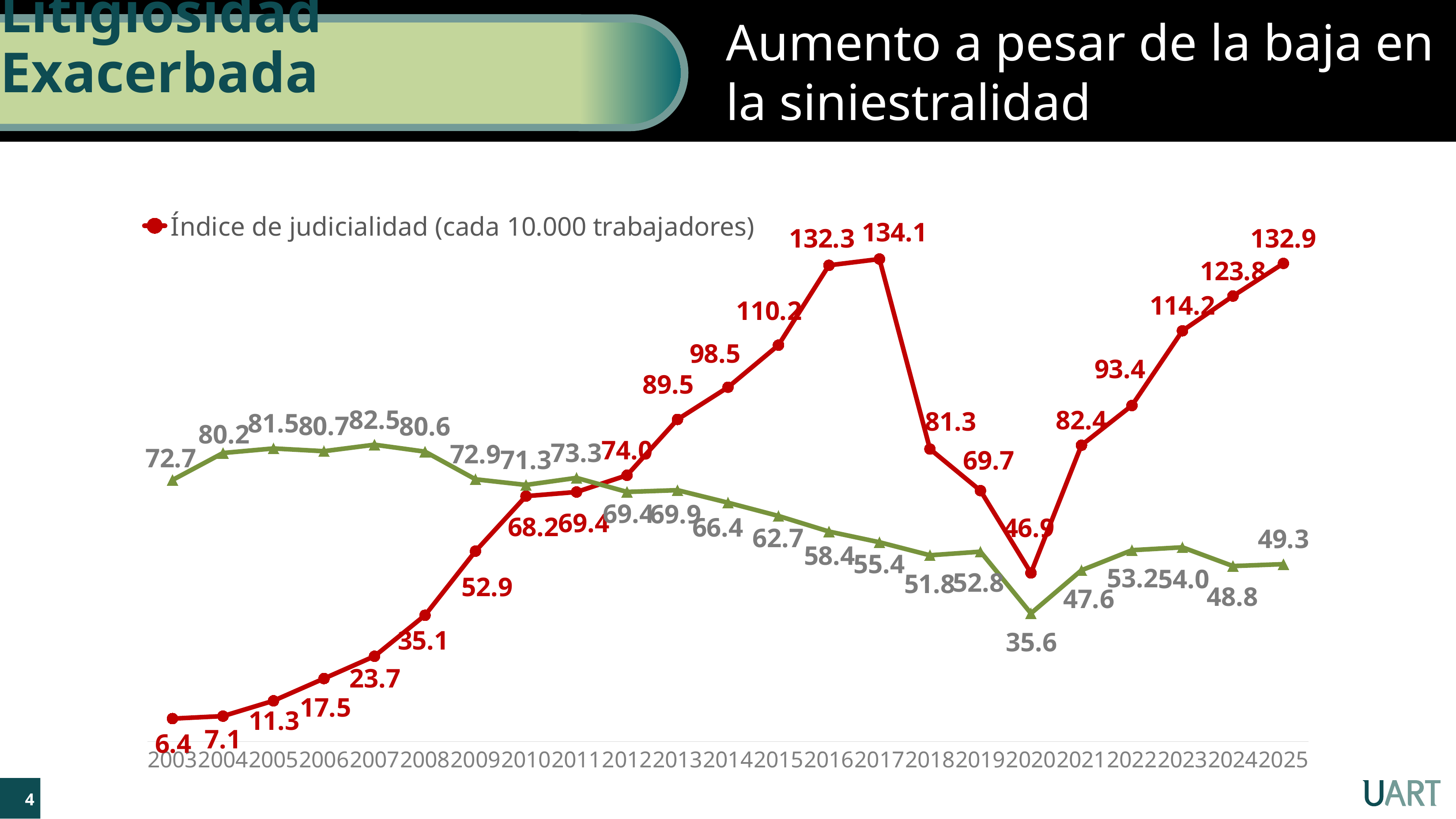
In which year does the Índice de judicialidad (cada 10.000 trabajadores) reach its highest value? 2017 In which year is the Índice de judicialidad (cada 10.000 trabajadores) lowest? 2003 In 2010, which is larger: the Índice de judicialidad (68.2) or the green line (71.3)? The green line What is the value of the Índice de judicialidad (cada 10.000 trabajadores) in 2017? 134.1 Does the green line rise or fall overall from 2003 to 2025? Fall What kind of chart is shown on the slide? Line chart How many series does the chart's legend list? 1 What is the value of the green line in 2020? 35.6 What is the difference between the Índice de judicialidad values for 2025 and 2024? 9.1 What is the value of the green line in 2007? 82.5 How many years are shown on the x axis of the chart? 23 What is the value of the Índice de judicialidad (cada 10.000 trabajadores) in 2003? 6.4